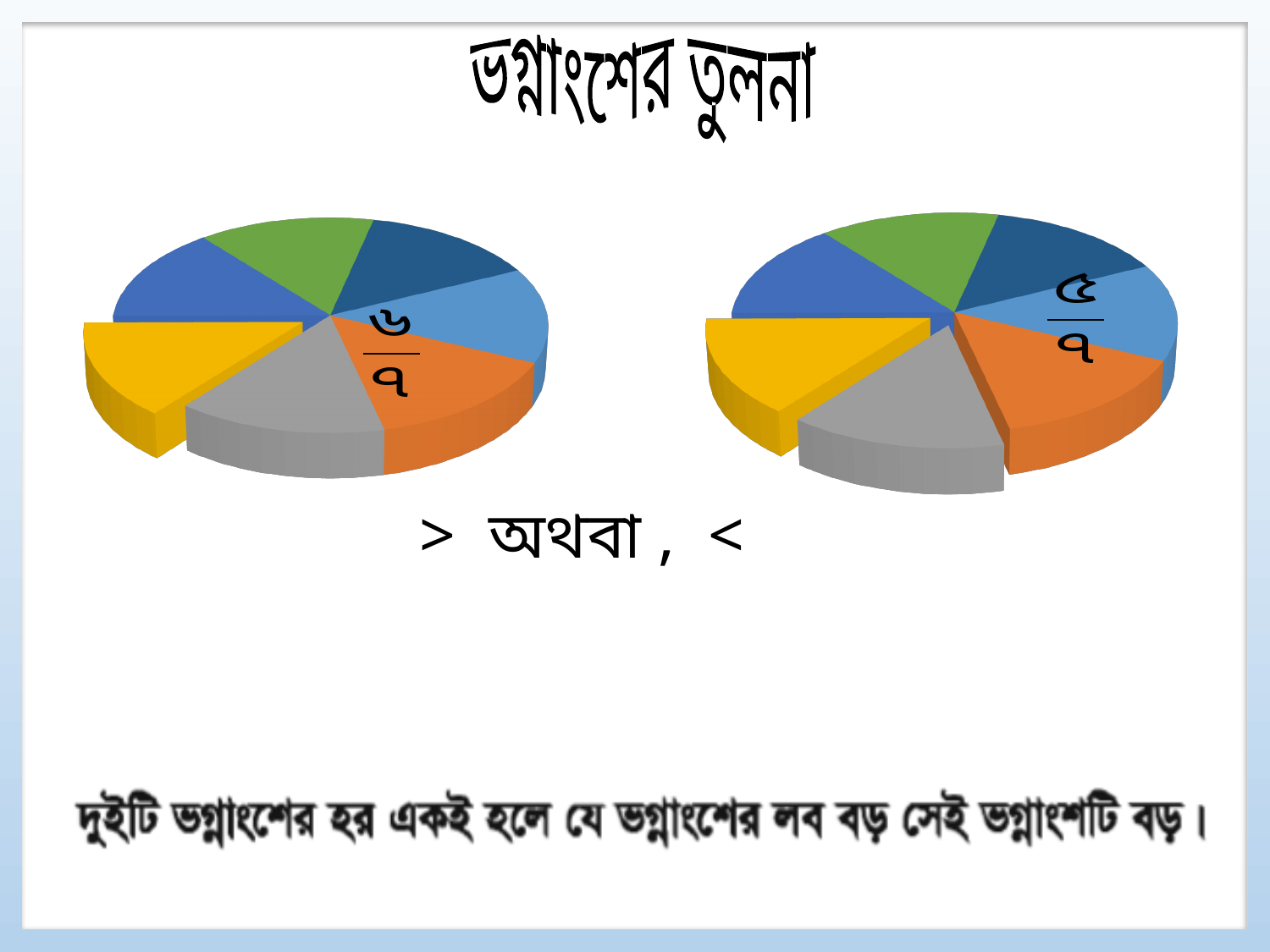
Which chart shows the larger fraction, the left pie chart or the right pie chart? the left pie chart (৬/৭) How many slices does the right pie chart have? 7 What kind of chart is the right chart on the slide? pie chart What fraction is printed on the right pie chart? ৫/৭ What kind of chart is the left chart on the slide? pie chart What fraction is printed on the left pie chart? ৬/৭ What is the denominator of the fraction printed on the right pie chart? ৭ How many pie charts are shown on the slide? 2 What is the title of the slide above the two pie charts? ভগ্নাংশের তুলনা How many slices are pulled out from the left pie chart? 2 How many slices does the left pie chart have? 7